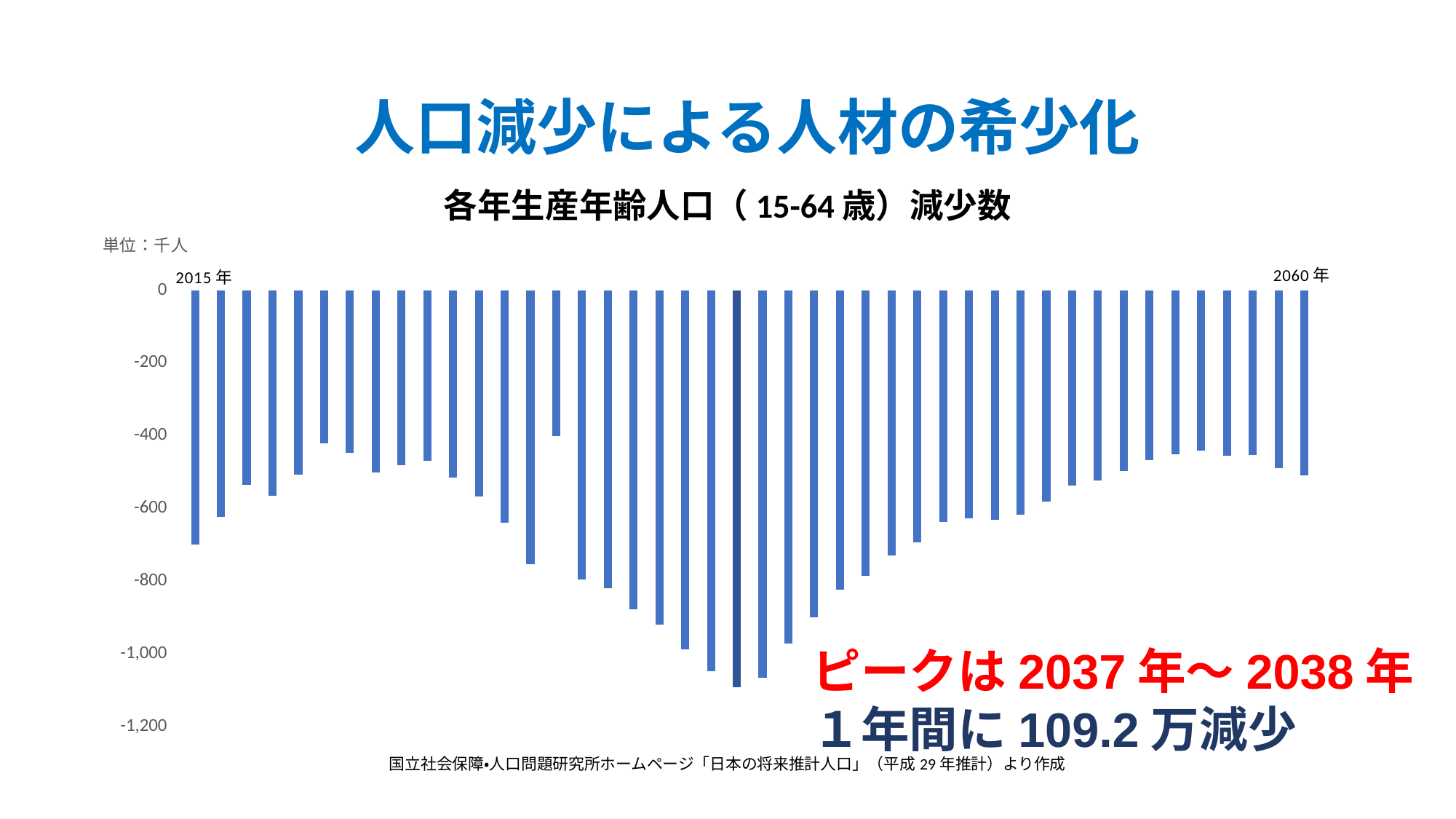
What is the lowest tick value shown on the y axis? -1,200 Do the bars get longer or shorter from 2015 toward the late 2030s? longer What is the title of the chart? 各年生産年齢人口（15-64歳）減少数 What kind of chart is shown on the slide? bar chart Which bar extends further below zero, the one for 2015 or the one for 2060? 2015 What is the last year shown on the x axis of the chart? 2060年 Is the value for 2015 greater or less than -600? less Is the value for 2060 greater or less than -600? greater What unit is stated for the chart's values? 千人 What is the first year shown on the x axis of the chart? 2015年 Does any bar in the chart reach below -1,200? No